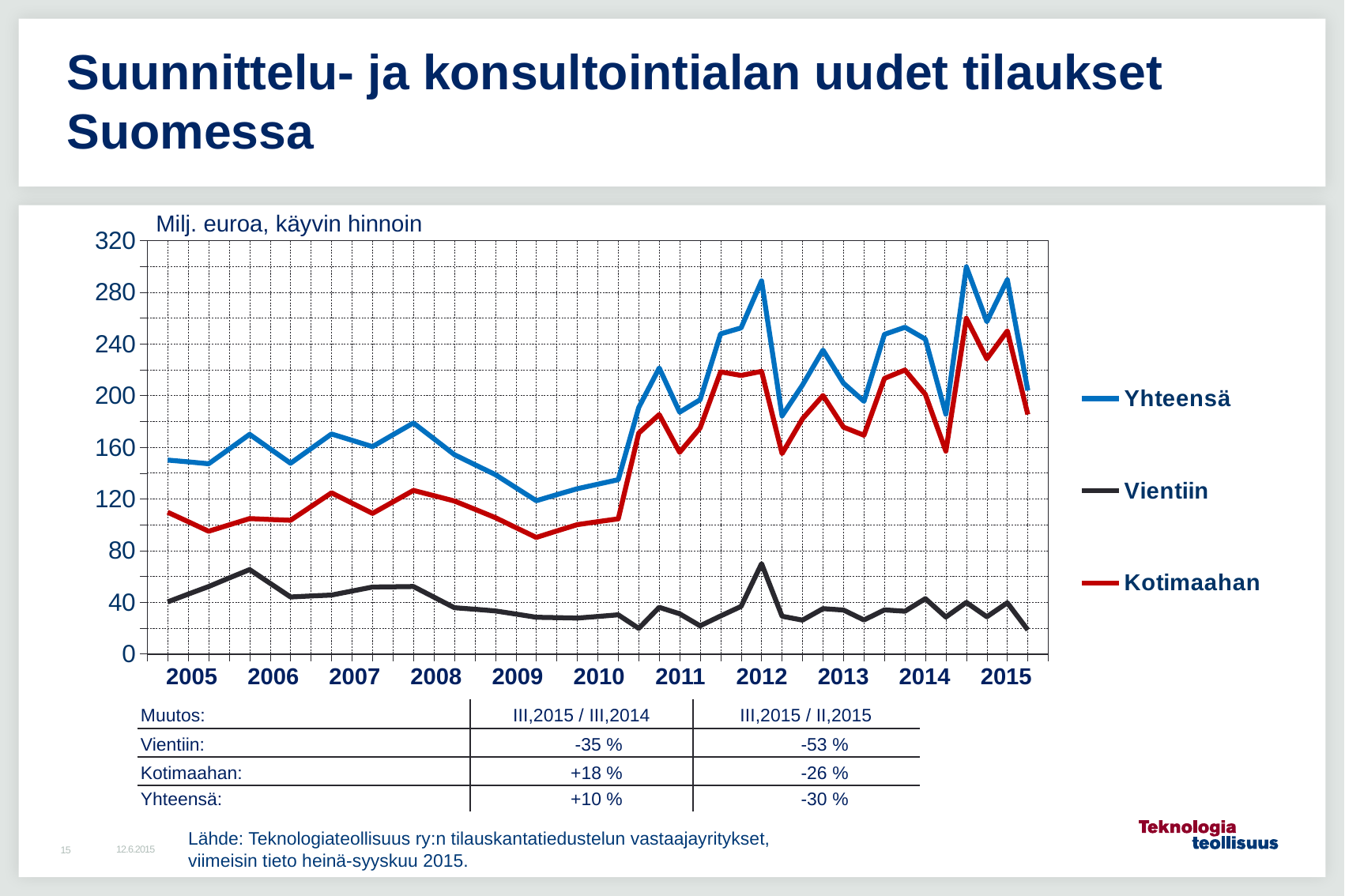
What are the three series named in the chart legend? Yhteensä, Vientiin, Kotimaahan Which series has the highest values throughout the chart? Yhteensä Is the peak value of the Vientiin line in 2012 greater or less than 40? greater How many years are labelled on the chart's x axis? 11 How many series does the chart legend list? 3 Is the lowest value of the Kotimaahan line in 2009 greater or less than 120? less What unit label is shown above the chart's y axis? Milj. euroa, käyvin hinnoin Which series has the lowest values throughout the chart? Vientiin Is the peak value of the Yhteensä line in 2014 greater or less than 280? greater Does the Yhteensä line generally rise or fall between 2009 and 2012? rise What kind of chart is shown on the slide? line chart Which is larger in 2012, the Kotimaahan value or the Vientiin value? Kotimaahan